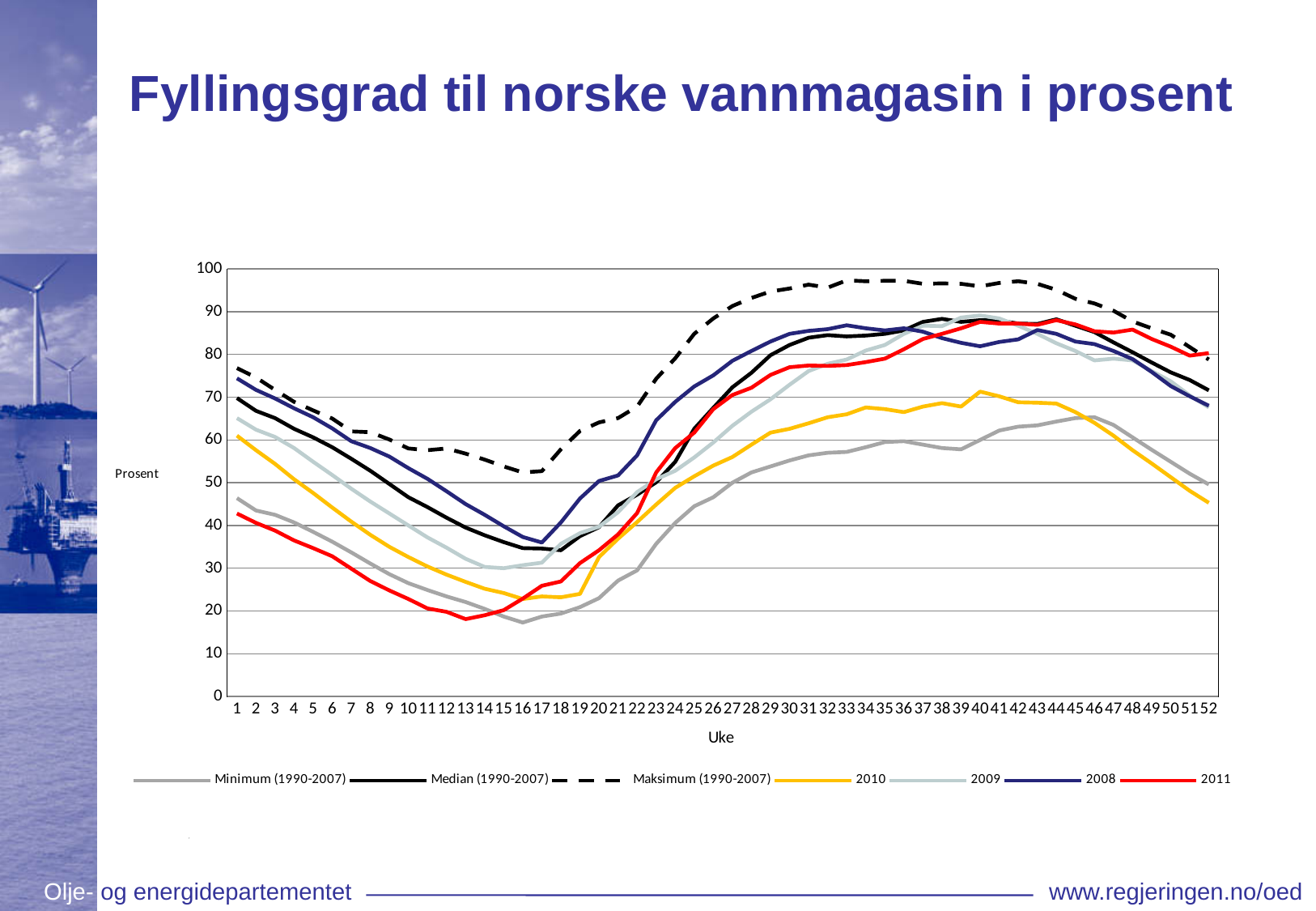
Is the value for 2010 at week 52 greater or less than 50? less Does the Minimum (1990-2007) series rise or fall from week 1 to week 16? fall Does the Median (1990-2007) series rise or fall from week 17 to week 38? rise How many weeks (Uke) are plotted along the x axis? 52 How many series does the legend list? 7 What is the label of the x axis? Uke At week 52, which series has the higher value, 2008 or 2011? 2011 Which series is the highest at week 30? Maksimum (1990-2007) What type of chart is shown on the slide? line chart At week 1, which series has the higher value, 2008 or 2011? 2008 Is the value for Maksimum (1990-2007) at week 33 greater or less than 90? greater Which series is the lowest at week 13? 2011